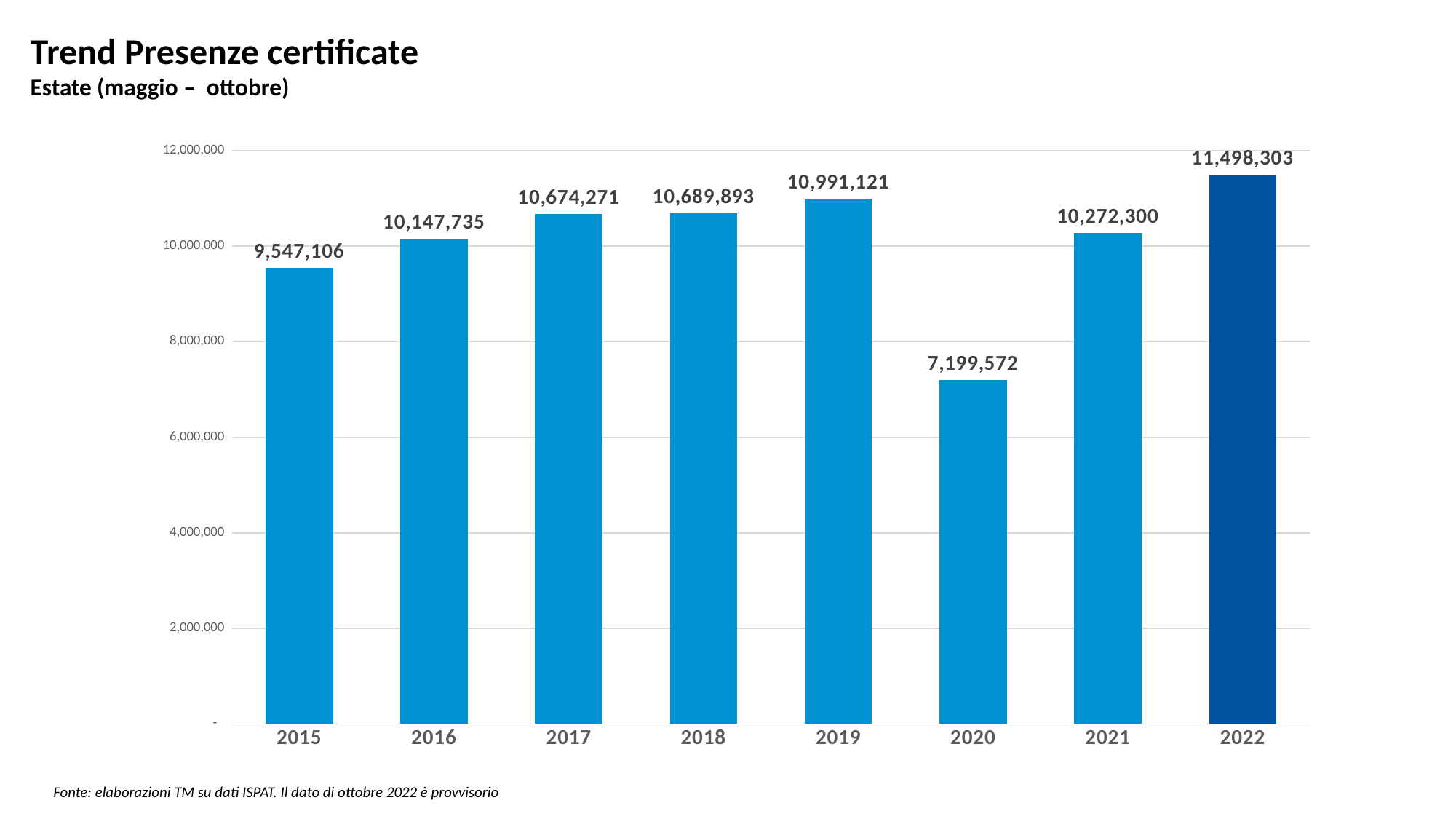
What is the difference between the values for 2019 and 2020? 3,791,549 Which year has the lowest value? 2020 What is the value for 2019? 10,991,121 What is the difference between the values for 2022 and 2021? 1,226,003 What is the value for 2015? 9,547,106 Which is larger, the value for 2019 or the value for 2021? 2019 Is the value for 2020 greater or less than 8,000,000? less Which year has the highest value? 2022 How many years are shown on the x axis? 8 What kind of chart is shown on the slide? bar chart What is the title of the chart? Trend Presenze certificate What is the value for 2020? 7,199,572